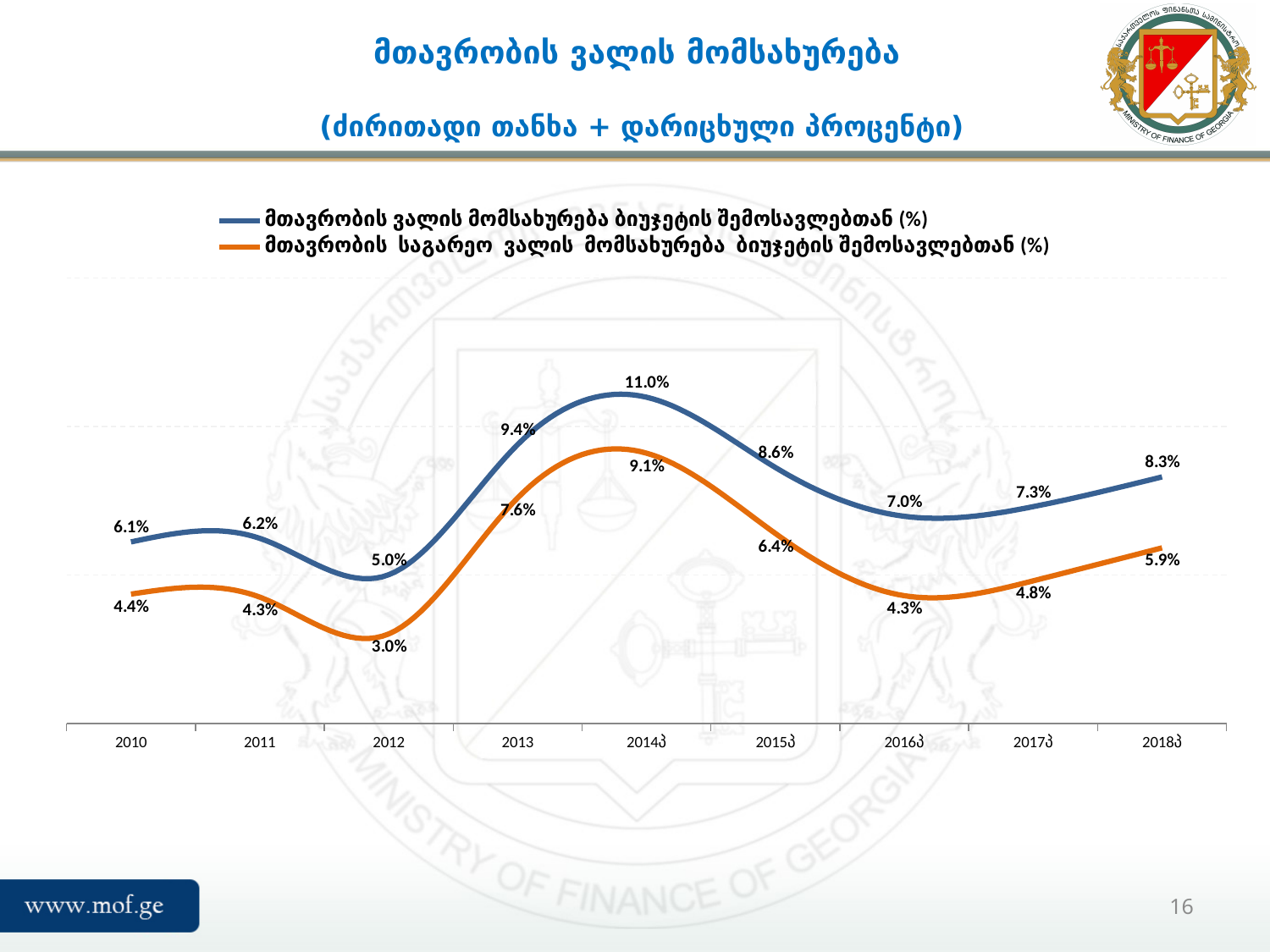
Does the blue line (მთავრობის ვალის მომსახურება) rise or fall from 2014პ to 2016პ? Fall What is the difference between the blue line and the orange line in 2016პ? 2.7% What is the value of the orange line (მთავრობის საგარეო ვალის მომსახურება ბიუჯეტის შემოსავლებთან) in 2012? 3.0% In which year does the blue line (მთავრობის ვალის მომსახურება) have its lowest value? 2012 What is the value of the blue line (მთავრობის ვალის მომსახურება) in 2018პ? 8.3% How many series does the legend list? 2 How many years are plotted along the x axis? 9 Which is larger: the orange line's value in 2013 or its value in 2015პ? 2013 (7.6%) What is the value of the blue line (მთავრობის ვალის მომსახურება ბიუჯეტის შემოსავლებთან) in 2014პ? 11.0% What colour is the line for მთავრობის საგარეო ვალის მომსახურება ბიუჯეტის შემოსავლებთან (%)? Orange What type of chart is shown on the slide? Line chart In which year does the orange line (მთავრობის საგარეო ვალის მომსახურება) reach its highest value? 2014პ